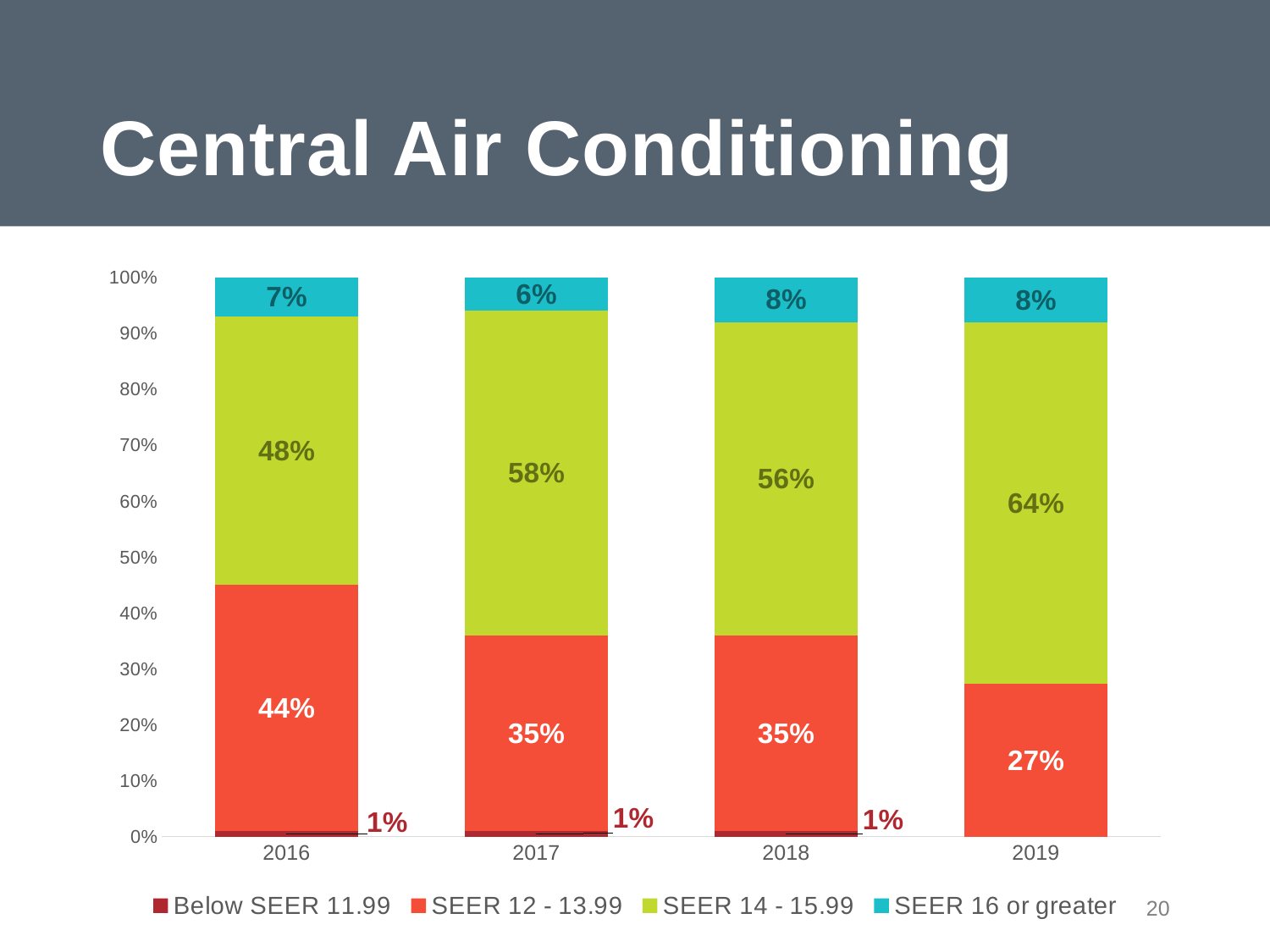
What is the value for SEER 14 - 15.99 in 2019? 64% What is the value for Below SEER 11.99 in 2018? 1% What is the value for SEER 16 or greater in 2017? 6% What kind of chart is shown on the slide? Stacked bar chart In which year is the SEER 12 - 13.99 share lowest? 2019 How many series does the legend list? 4 What is the value for SEER 12 - 13.99 in 2016? 44% What is the difference between the SEER 14 - 15.99 values for 2019 and 2016? 16% How many years are shown on the x axis? 4 Which is larger: SEER 12 - 13.99 in 2016 or SEER 12 - 13.99 in 2017? 2016 In which year is the SEER 14 - 15.99 share highest? 2019 Does the SEER 12 - 13.99 share rise or fall from 2016 to 2019? Fall